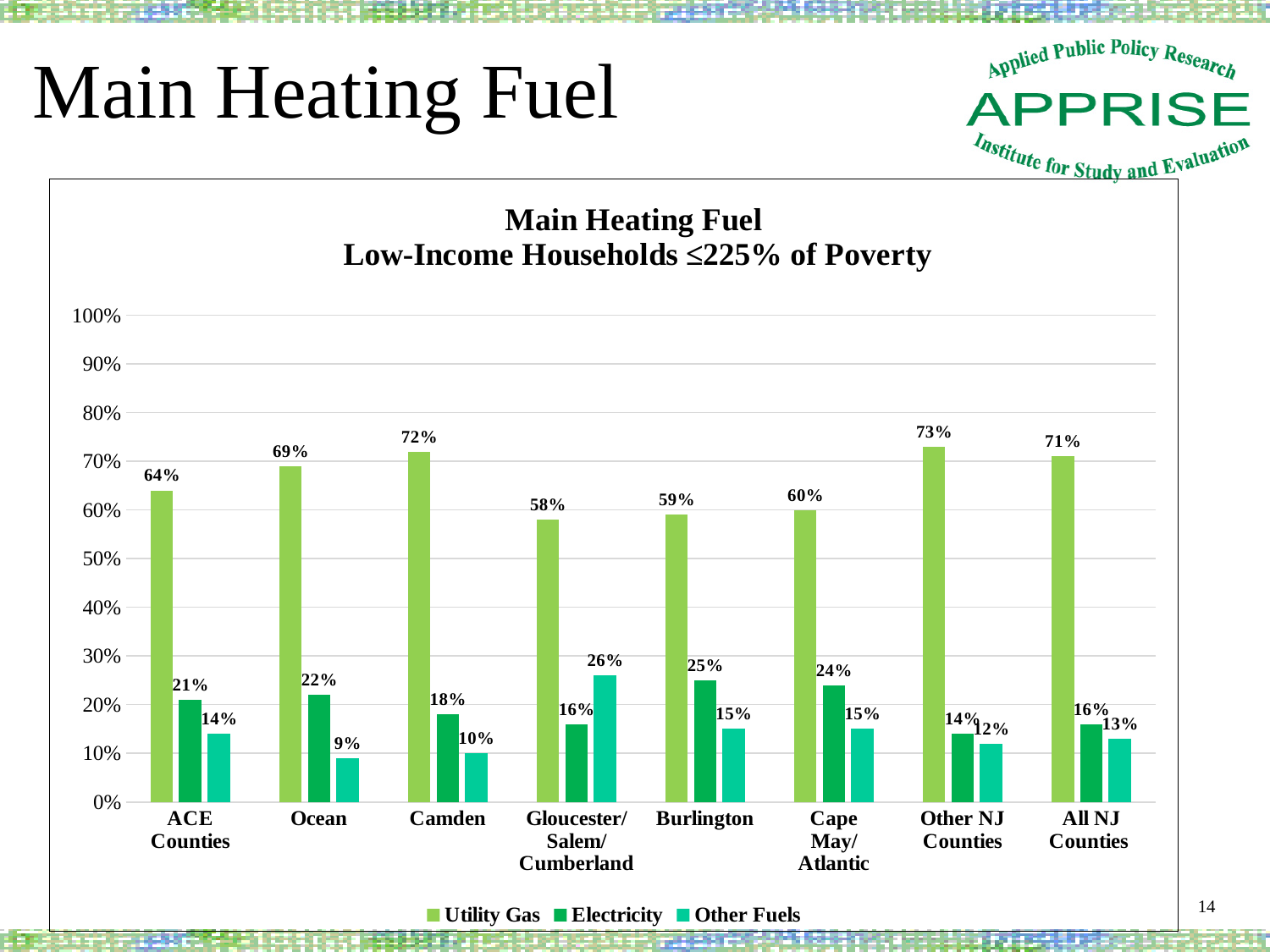
Which category has the highest Other Fuels value? Gloucester/Salem/Cumberland What percentage of low-income households in Camden use Utility Gas as their main heating fuel? 72% How many series does the legend list? 3 How many categories are shown on the x axis? 8 What is the Electricity value for All NJ Counties? 16% What kind of chart is shown on the slide? Bar chart Which is larger for Burlington: the Electricity value or the Other Fuels value? Electricity What is the difference between the Utility Gas values for Other NJ Counties and ACE Counties? 9% What is the Other Fuels value for Ocean? 9% Which category has the lowest Utility Gas value? Gloucester/Salem/Cumberland Which category has the highest Utility Gas value? Other NJ Counties What is the Electricity value for Cape May/Atlantic? 24%